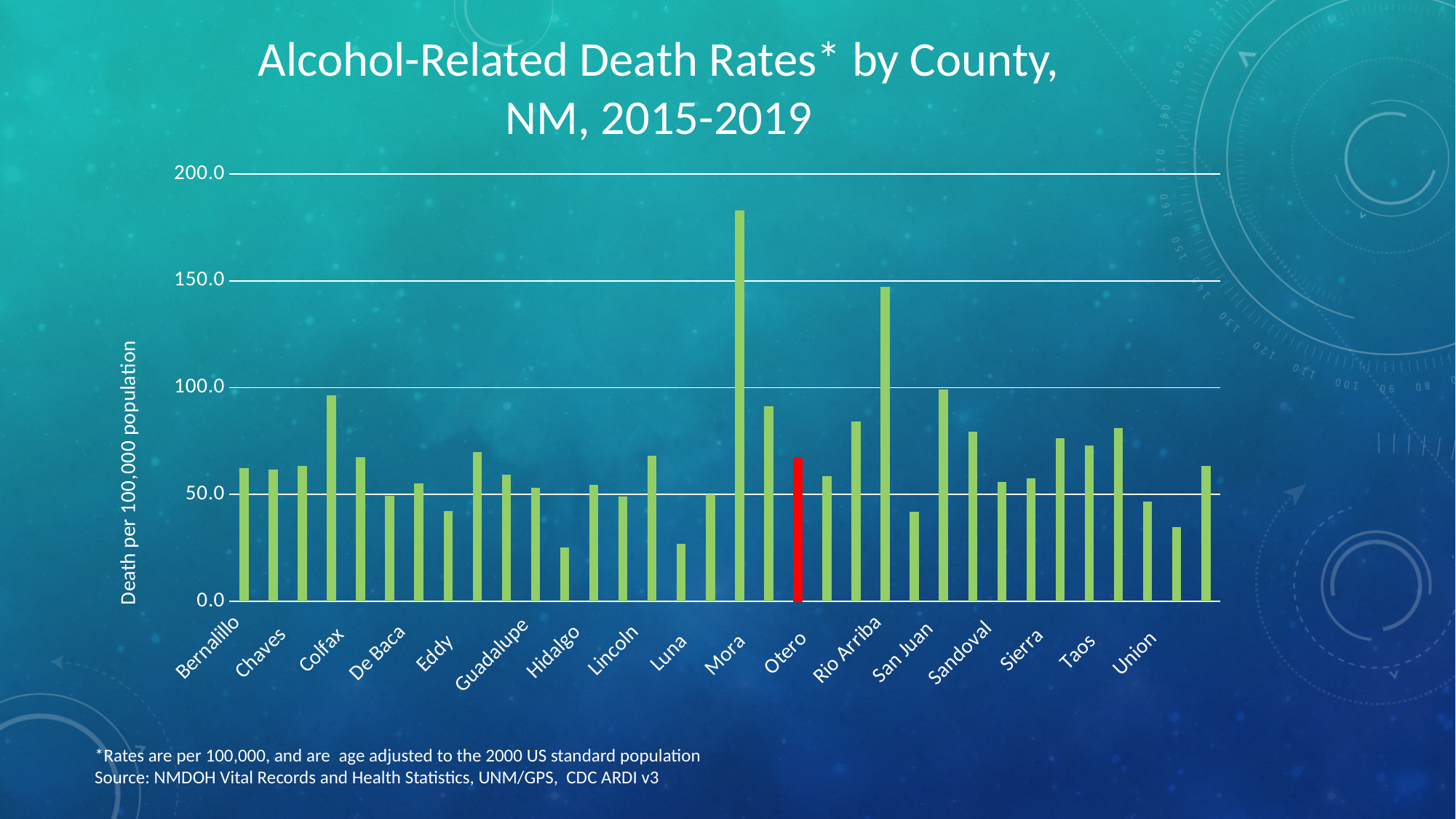
Is the value for Bernalillo greater or less than 50? greater What kind of chart is shown on the slide? bar chart Is the tallest bar in the chart greater or less than 150? greater What is the highest value shown on the vertical axis? 200.0 Which has the higher alcohol-related death rate, Otero or Union? Otero Is the value for Otero greater or less than 50? greater What is the label of the vertical axis? Death per 100,000 population